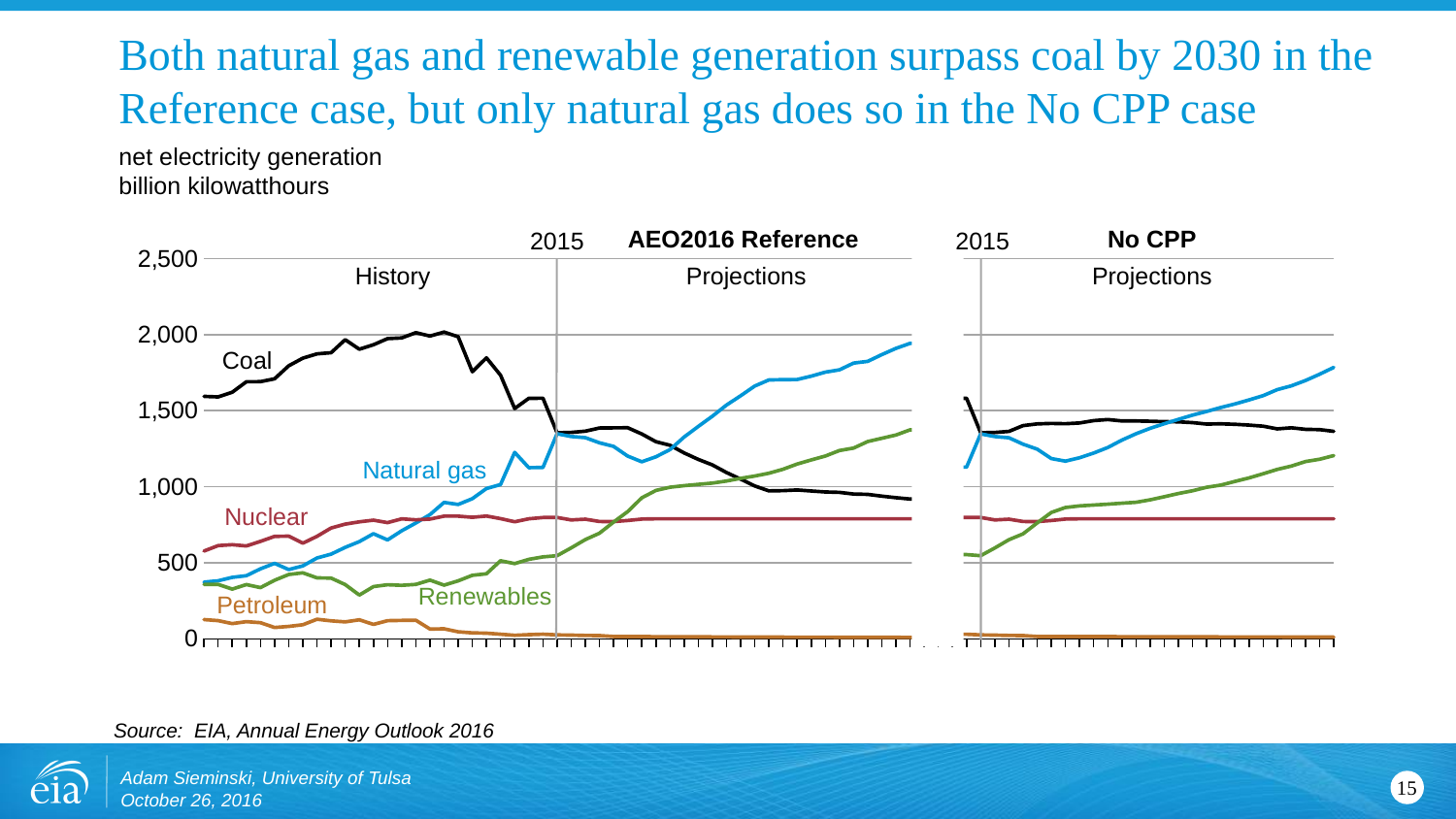
At the end of the No CPP projections, which is larger: coal or renewables? Coal In the No CPP case, is the value for coal at the end of the projections greater or less than 1,500? less In the No CPP projections, does renewables generation rise or fall over time? rise What unit is net electricity generation measured in on this chart? billion kilowatthours In the AEO2016 Reference projections, does coal generation rise or fall over time? fall In the AEO2016 Reference projections, which series is highest at the end of the projection period? Natural gas In the AEO2016 Reference projections, is the value for nuclear greater or less than 1,000? less How many fuel series are labeled on the chart? 5 Which series is the lowest across the whole chart? Petroleum What kind of chart is shown on the slide? line chart At the end of the AEO2016 Reference projections, which is larger: coal or renewables? Renewables In the AEO2016 Reference case, is the value for natural gas at the end of the projections greater or less than 1,500? greater